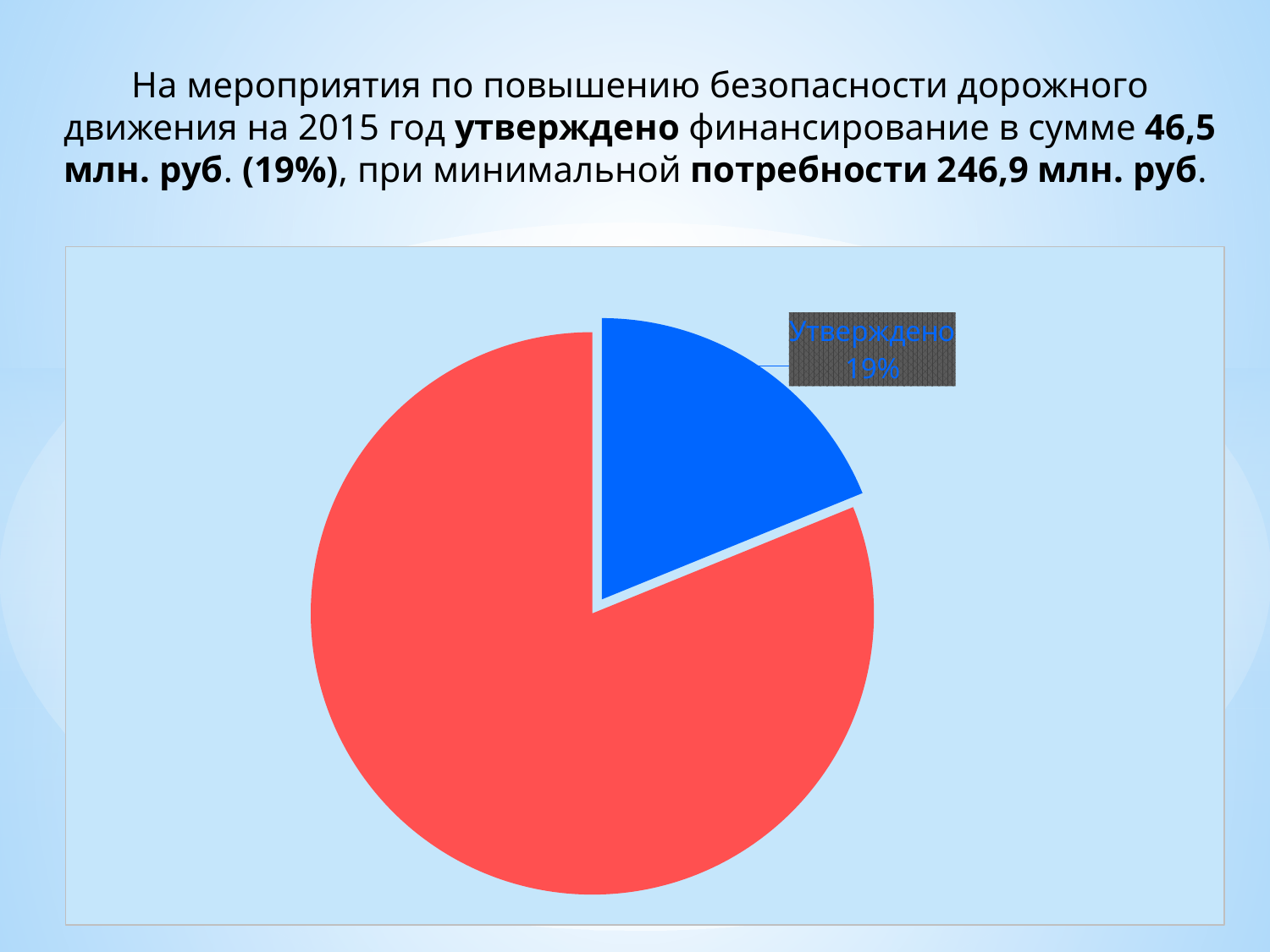
How many slices does the pie chart have? 2 What percentage value is printed in the data label on the pie chart? 19% What colour is the largest slice of the pie? red What colour is the "Утверждено" slice? blue Which slice is larger, the blue one or the red one? the red one What kind of chart is shown on the slide? pie chart What share of the pie does the "Утверждено" slice represent? 19% What label is attached to the blue slice of the pie? Утверждено Which slice of the pie is the smallest? Утверждено